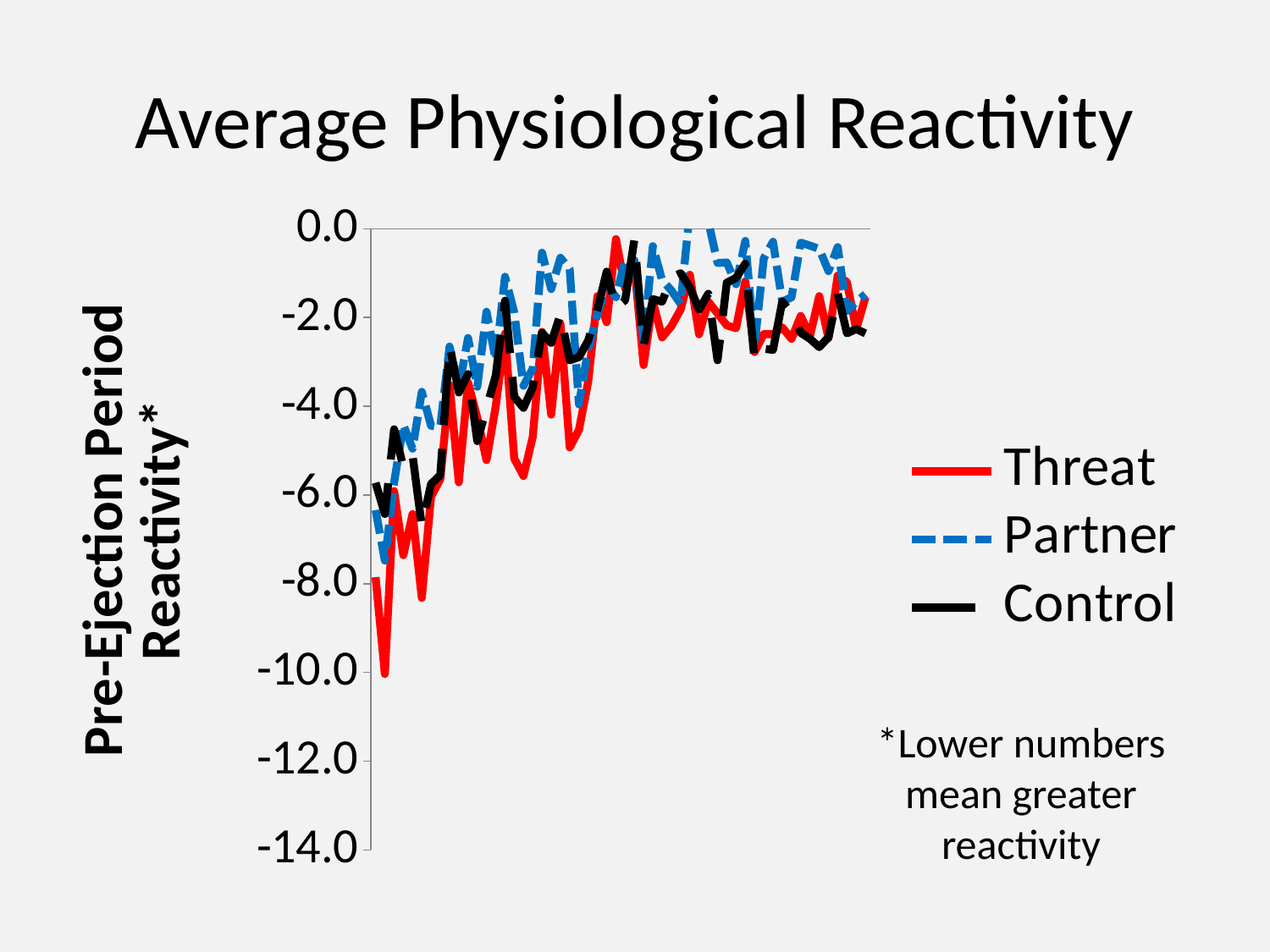
Which series reaches the lowest value on the chart? Threat What is the title of the chart? Average Physiological Reactivity At the start of the x axis, which line is lower, Threat or Partner? Threat Is the highest value of the Control line greater or less than -2.0? greater According to the footnote, what do lower numbers mean? greater reactivity Is the first value of the Threat line greater or less than -6.0? less Do the values of the Threat line generally rise or fall along the x axis? rise How many series does the legend list? 3 What kind of chart is shown on the slide? line chart Is the lowest value of the Threat line greater or less than -8.0? less Do the values of the Control line generally rise or fall along the x axis? rise